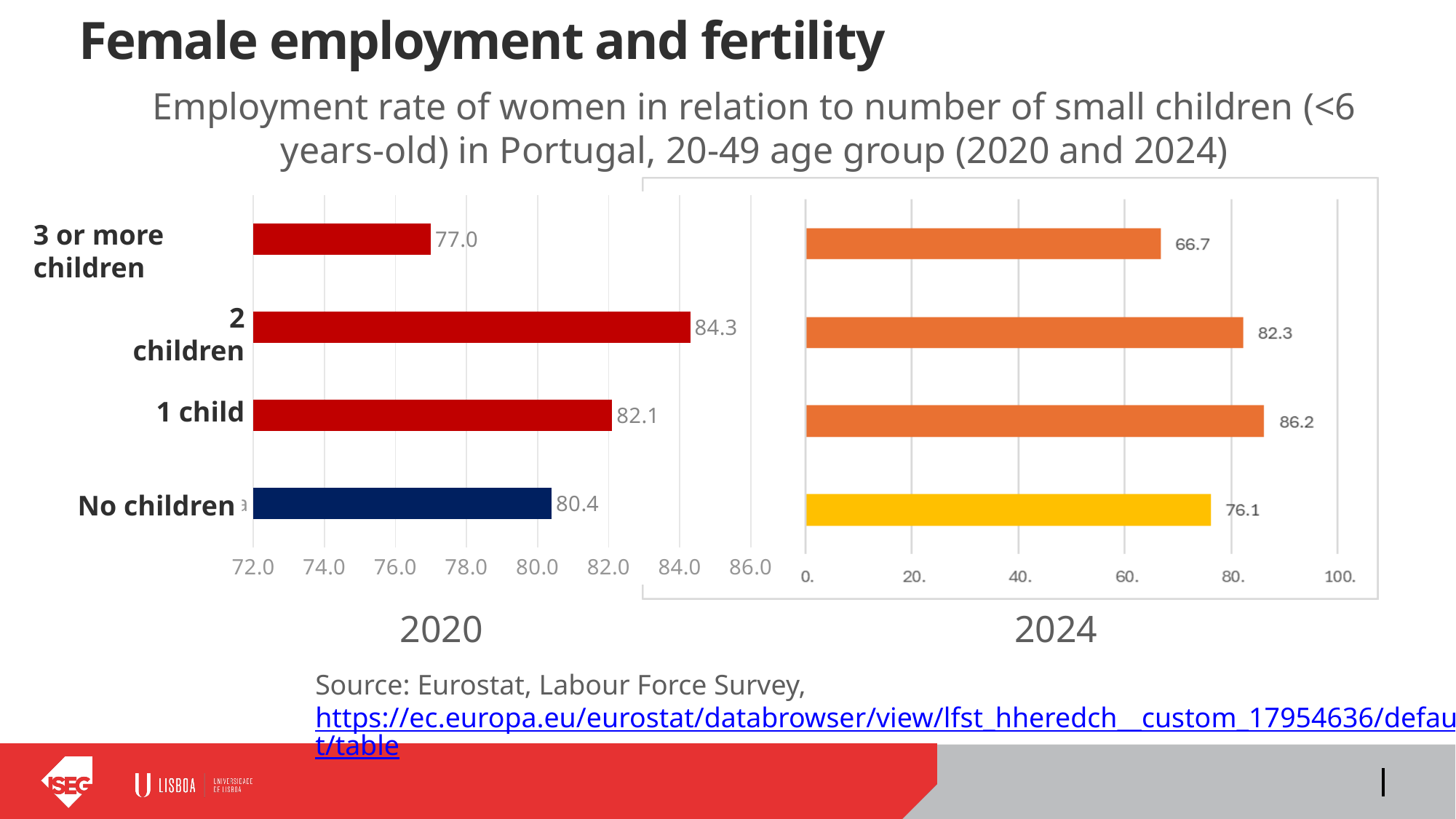
In the 2020 chart, which category has the highest employment rate? 2 children In the 2024 chart, what is the difference between the values for 1 child and 3 or more children? 19.5 In the 2020 chart, which category has the lowest employment rate? 3 or more children In the 2020 chart, what is the value for No children? 80.4 In the 2020 chart, what is the employment rate for women with 2 children? 84.3 How many categories are shown in the 2020 chart? 4 In the 2024 chart, what is the value for 1 child? 86.2 In the 2020 chart, what is the difference between the values for 2 children and No children? 3.9 In the 2024 chart, which category has the lowest employment rate? 3 or more children What type of chart is used for the 2024 data? Bar chart In the 2024 chart, what is the employment rate for women with 3 or more children? 66.7 Which is larger: the 2020 value for 1 child or the 2024 value for 1 child? 2024 value for 1 child